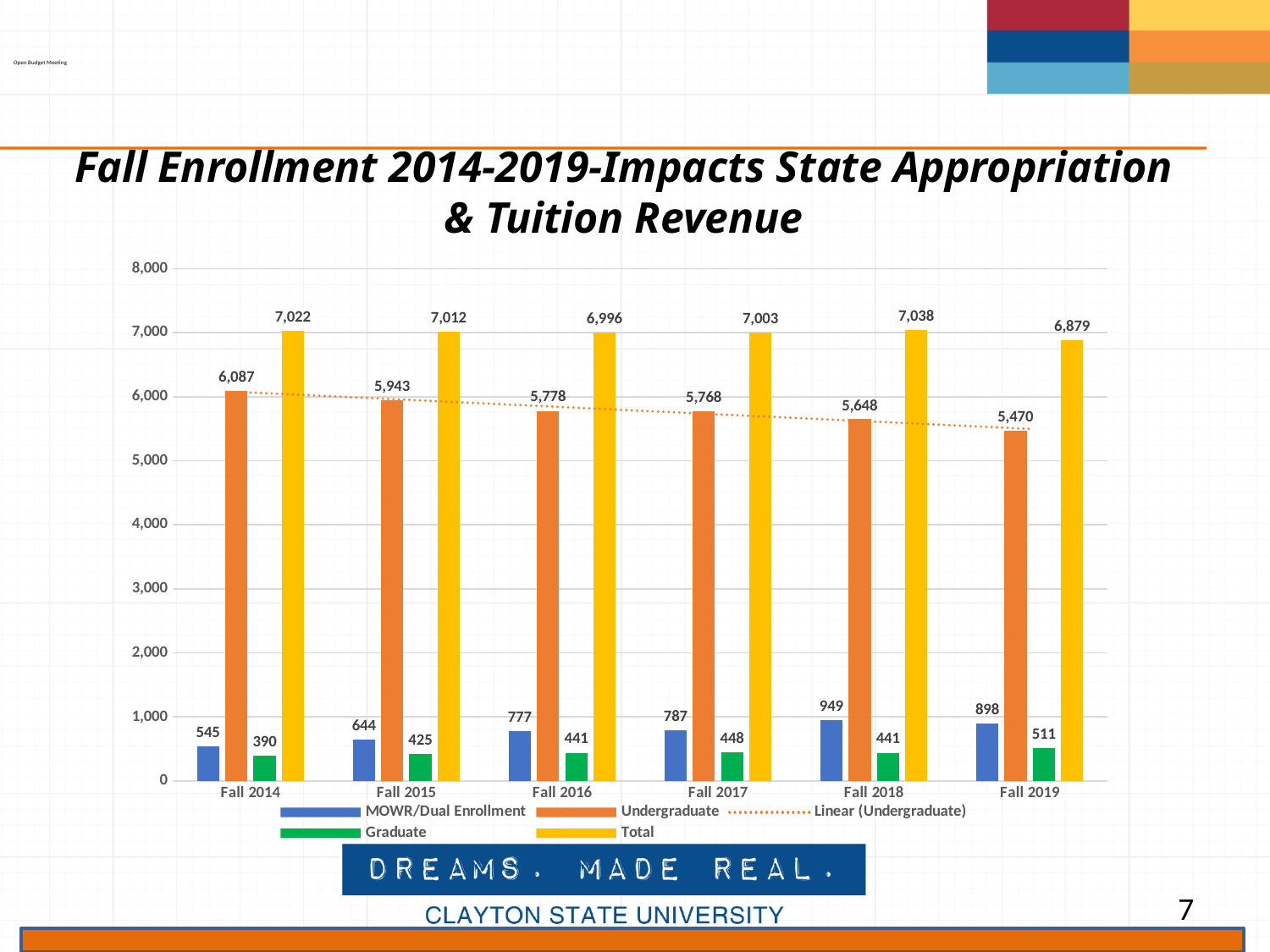
Which fall term has the lowest Graduate enrollment? Fall 2014 Does the Undergraduate enrollment rise or fall from Fall 2014 to Fall 2019? Fall How many entries does the legend list? 5 What is the MOWR/Dual Enrollment value for Fall 2018? 949 How many fall terms are shown on the x axis? 6 What is the Total enrollment for Fall 2019? 6,879 Which fall term has the highest Total enrollment? Fall 2018 Which is larger, the MOWR/Dual Enrollment value for Fall 2018 or for Fall 2019? Fall 2018 What kind of chart is shown on the slide? Bar chart What colour are the Total bars? Yellow What is the difference between the Undergraduate enrollment in Fall 2014 and Fall 2019? 617 What is the Undergraduate enrollment for Fall 2016? 5,778